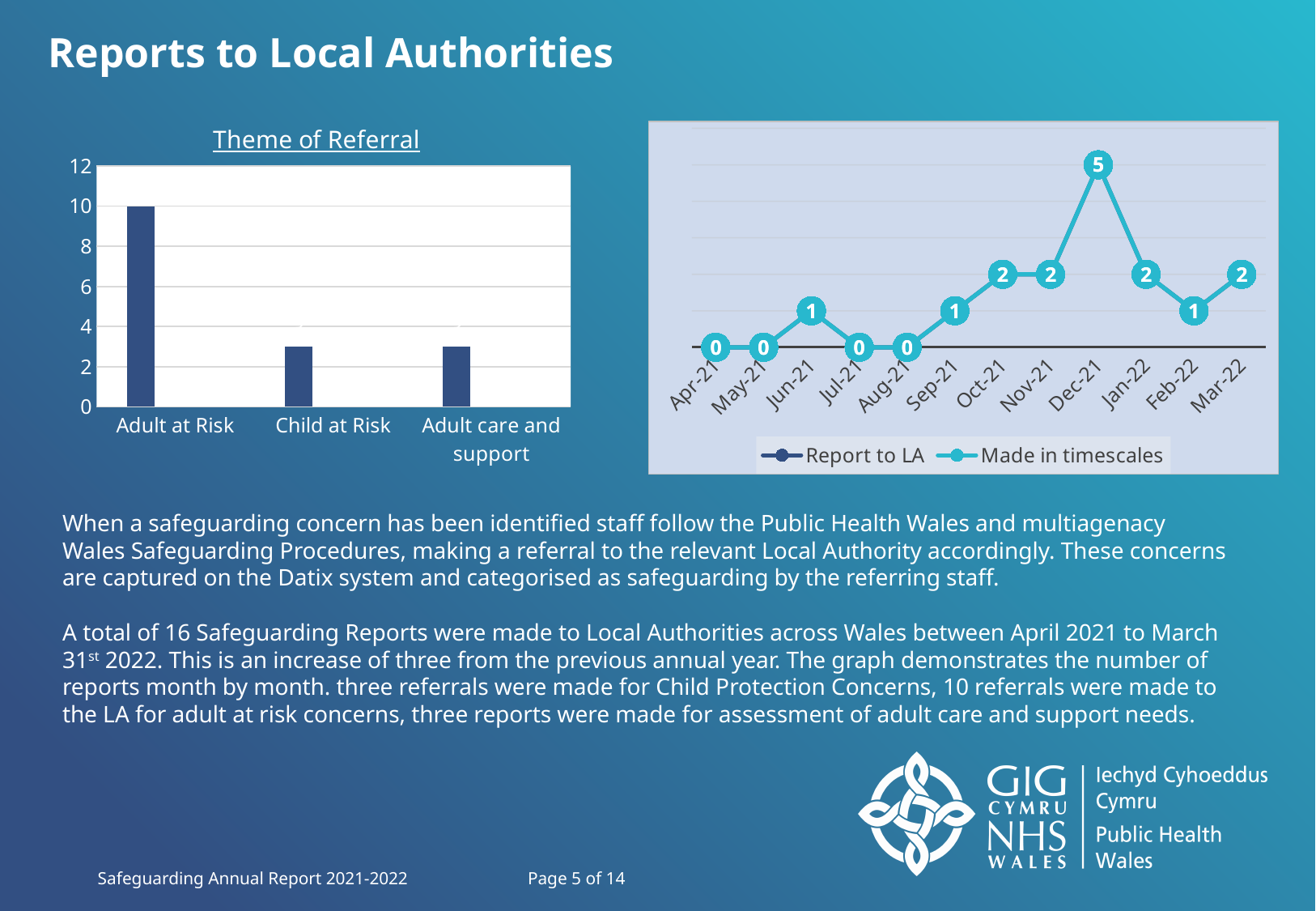
On the Theme of Referral chart, is the value for Child at Risk greater or less than 4? less On the Theme of Referral chart, how many categories are shown? 3 On the line chart on the right, which month has the highest value? Dec-21 On the line chart on the right, how many series does the legend list? 2 On the line chart on the right, which is larger, the value for Oct-21 or the value for Feb-22? Oct-21 On the line chart on the right, what is the value for Dec-21? 5 On the Theme of Referral chart, which category has the highest value? Adult at Risk What kind of chart is the Theme of Referral chart? bar chart On the line chart on the right, how many months are plotted along the x axis? 12 On the Theme of Referral chart, what is the value for Adult at Risk? 10 On the line chart on the right, what is the value for Jun-21? 1 On the line chart on the right, what is the difference between the values for Dec-21 and Jan-22? 3